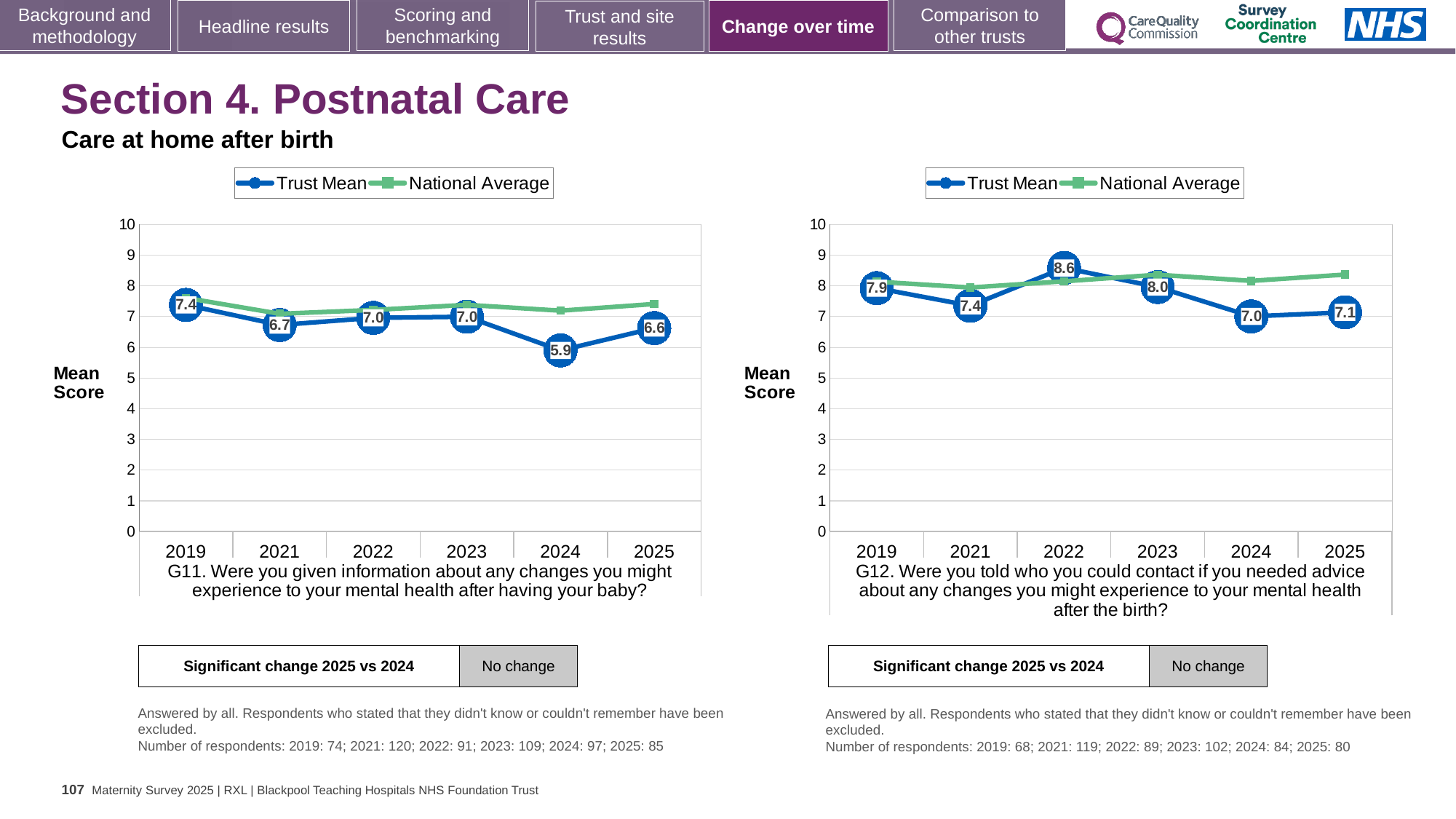
What type of chart is the right chart (G12)? Line chart In the right chart (G12), what is the Trust Mean score for 2025? 7.1 In the left chart (G11), is the National Average for 2025 greater or less than 7? greater In the right chart (G12), what is the difference between the Trust Mean scores for 2022 and 2024? 1.6 How many years are plotted on the x axis of the right chart (G12)? 6 In the right chart (G12), what is the Trust Mean score for 2022? 8.6 In the left chart (G11), what is the Trust Mean score for 2019? 7.4 In the right chart (G12), which year has the highest Trust Mean score? 2022 In the left chart (G11), what is the Trust Mean score for 2024? 5.9 How many series does the legend of the left chart (G11) list? 2 In the left chart (G11), which year has the lowest Trust Mean score? 2024 In the left chart (G11), which is larger, the Trust Mean score for 2019 or for 2025? 2019